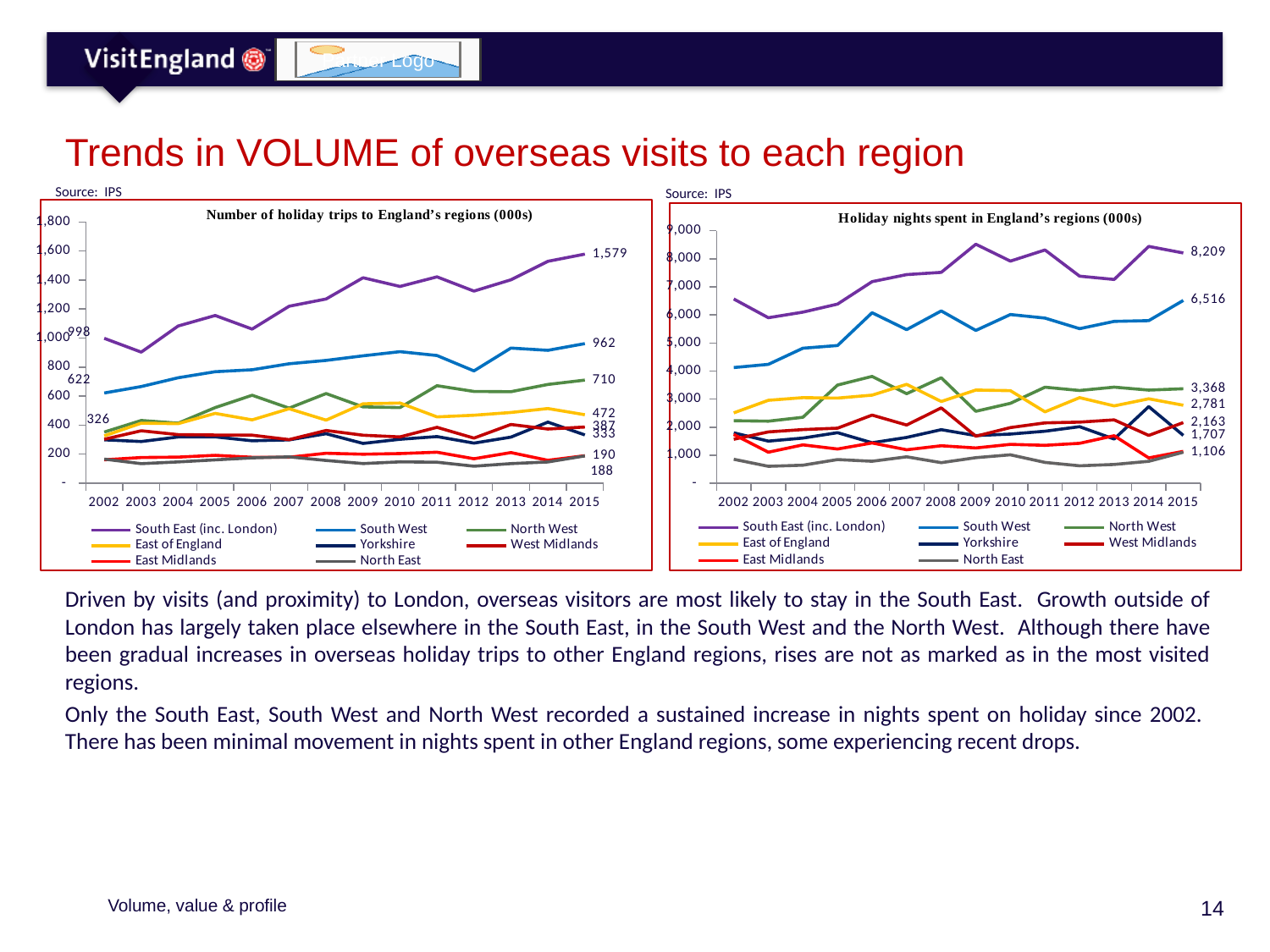
In the 'Number of holiday trips to England's regions (000s)' chart, what is the value for South East (inc. London) in 2015? 1,579 How many series does the legend of the 'Number of holiday trips to England's regions (000s)' chart list? 8 How many years are shown on the x axis of the 'Holiday nights spent in England's regions (000s)' chart? 14 In the 'Number of holiday trips to England's regions (000s)' chart, what is the value for South West in 2015? 962 In the 'Holiday nights spent in England's regions (000s)' chart, what is the value for North West in 2015? 3,368 In the 'Holiday nights spent in England's regions (000s)' chart, what is the value for South East (inc. London) in 2015? 8,209 What kind of chart is the 'Holiday nights spent in England's regions (000s)' chart? Line chart In the 'Holiday nights spent in England's regions (000s)' chart, does the South East (inc. London) line generally rise or fall from 2002 to 2015? Rise In the 'Number of holiday trips to England's regions (000s)' chart, what is the difference between the South East (inc. London) and South West values in 2015? 617 In the 'Holiday nights spent in England's regions (000s)' chart, is the value for South West in 2002 greater or less than 5,000? less In the 'Number of holiday trips to England's regions (000s)' chart, which region has the highest value in 2015? South East (inc. London) In the 'Number of holiday trips to England's regions (000s)' chart, what is the value for South East (inc. London) in 2002? 998